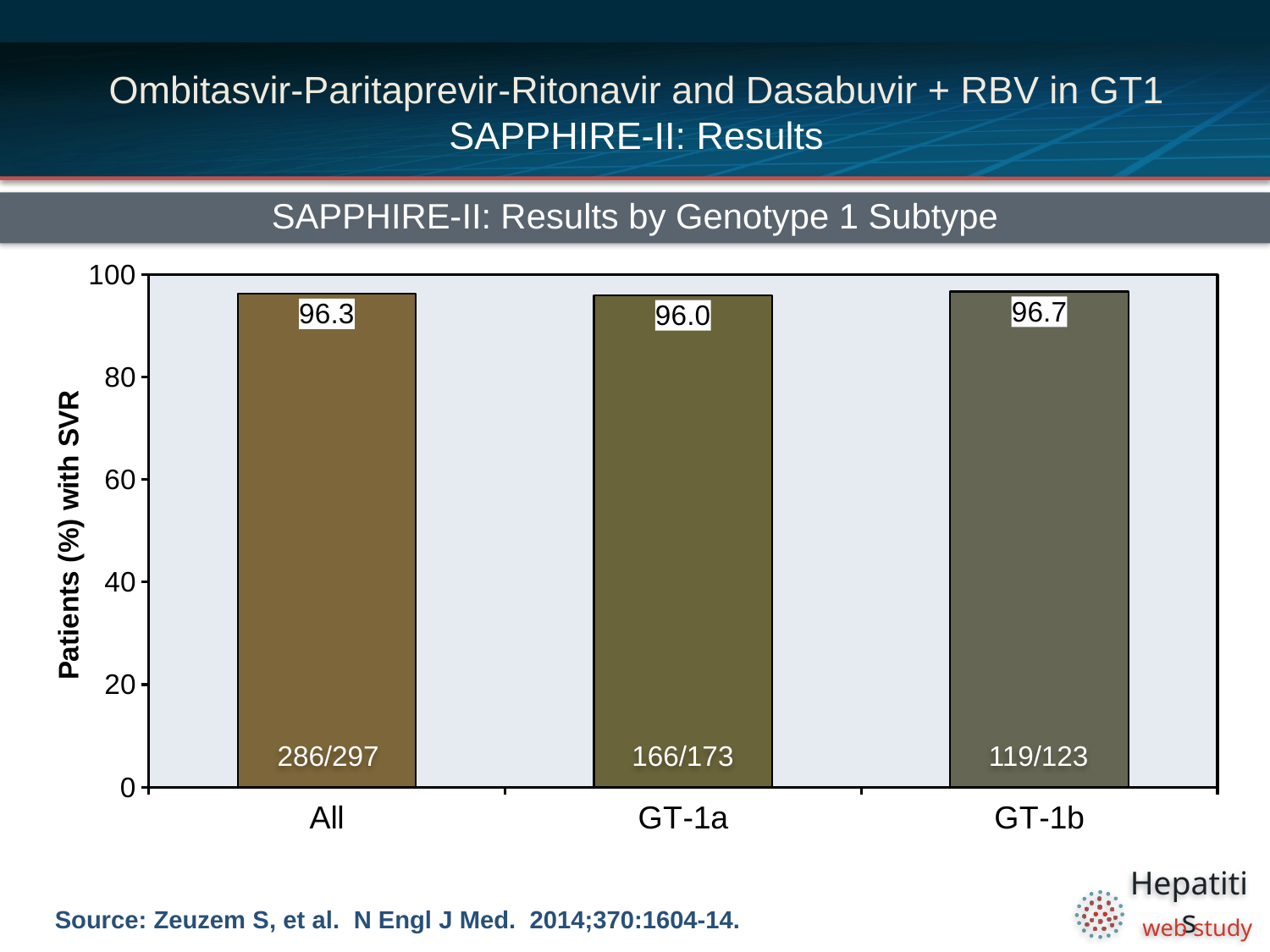
What is the SVR rate (%) for GT-1b? 96.7 What kind of chart is shown on the slide? Bar chart What is the SVR rate (%) for the All group? 96.3 What is the label of the y axis? Patients (%) with SVR How many categories are shown on the x axis of the chart? 3 Which category has the lowest SVR rate according to the data labels? GT-1a What fraction of patients is printed on the GT-1b bar? 119/123 What fraction of patients is printed on the GT-1a bar? 166/173 What is the SVR rate (%) for GT-1a? 96.0 Which genotype subtype has the highest SVR rate according to the data labels? GT-1b What fraction of patients is printed on the All bar? 286/297 What is the difference in SVR rate between GT-1b and GT-1a? 0.7